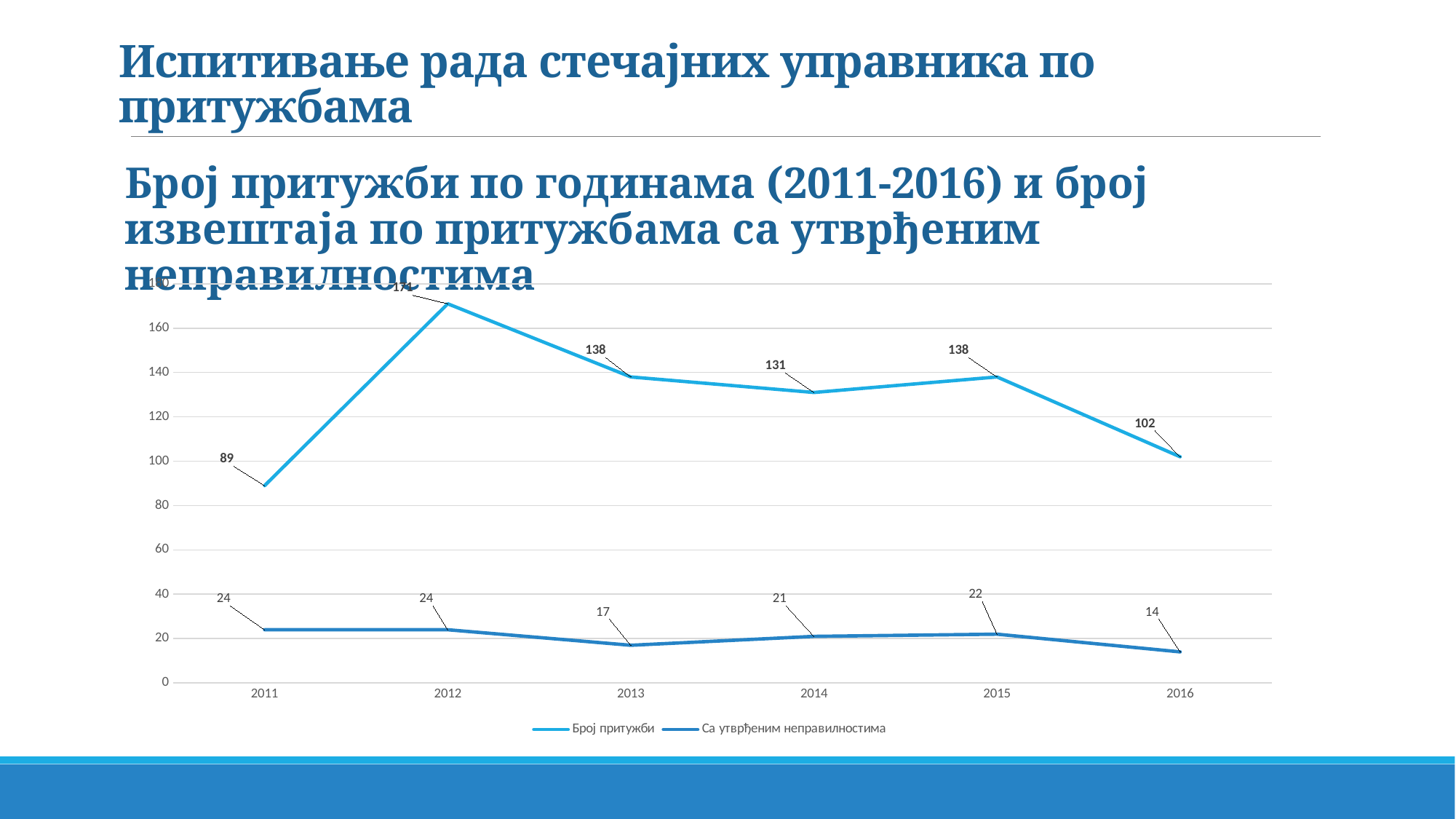
Which year has the larger value of Број притужби, 2014 or 2015? 2015 What is the value of Са утврђеним неправилностима for 2013? 17 How many series does the legend list? 2 In which year is Број притужби highest? 2012 In which year is Број притужби lowest? 2011 Is the value of Број притужби for 2012 greater or less than 160? greater What is the value of Са утврђеним неправилностима for 2016? 14 What kind of chart is shown on the slide? line chart In which year is Са утврђеним неправилностима lowest? 2016 What is the value of Број притужби for 2011? 89 What is the value of Број притужби for 2016? 102 What is the difference between Број притужби in 2013 and in 2016? 36